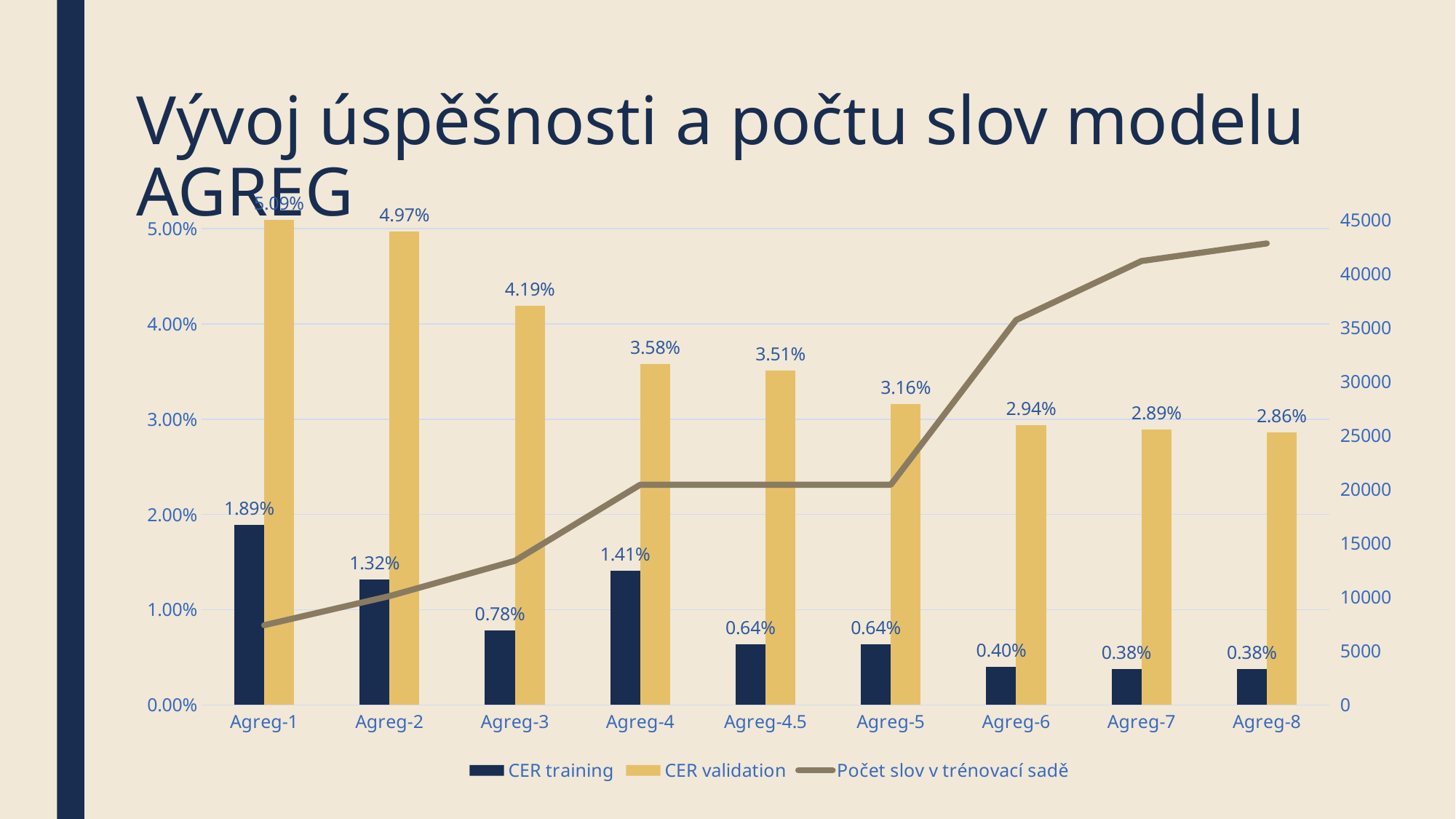
What is the CER validation value for Agreg-8? 2.86% Which has the larger CER training value, Agreg-3 or Agreg-4? Agreg-4 How many series does the legend list? 3 What is the CER validation value for Agreg-4? 3.58% What is the CER training value for Agreg-6? 0.40% What is the CER training value for Agreg-1? 1.89% What is the difference between the CER validation values for Agreg-2 and Agreg-3? 0.78% Which category has the lowest CER validation value? Agreg-8 Which category has the highest CER training value? Agreg-1 Does the Počet slov v trénovací sadě line rise or fall from Agreg-1 to Agreg-8? rise How many categories are shown on the x axis? 9 Is the value of Počet slov v trénovací sadě for Agreg-8 greater or less than 40000? greater